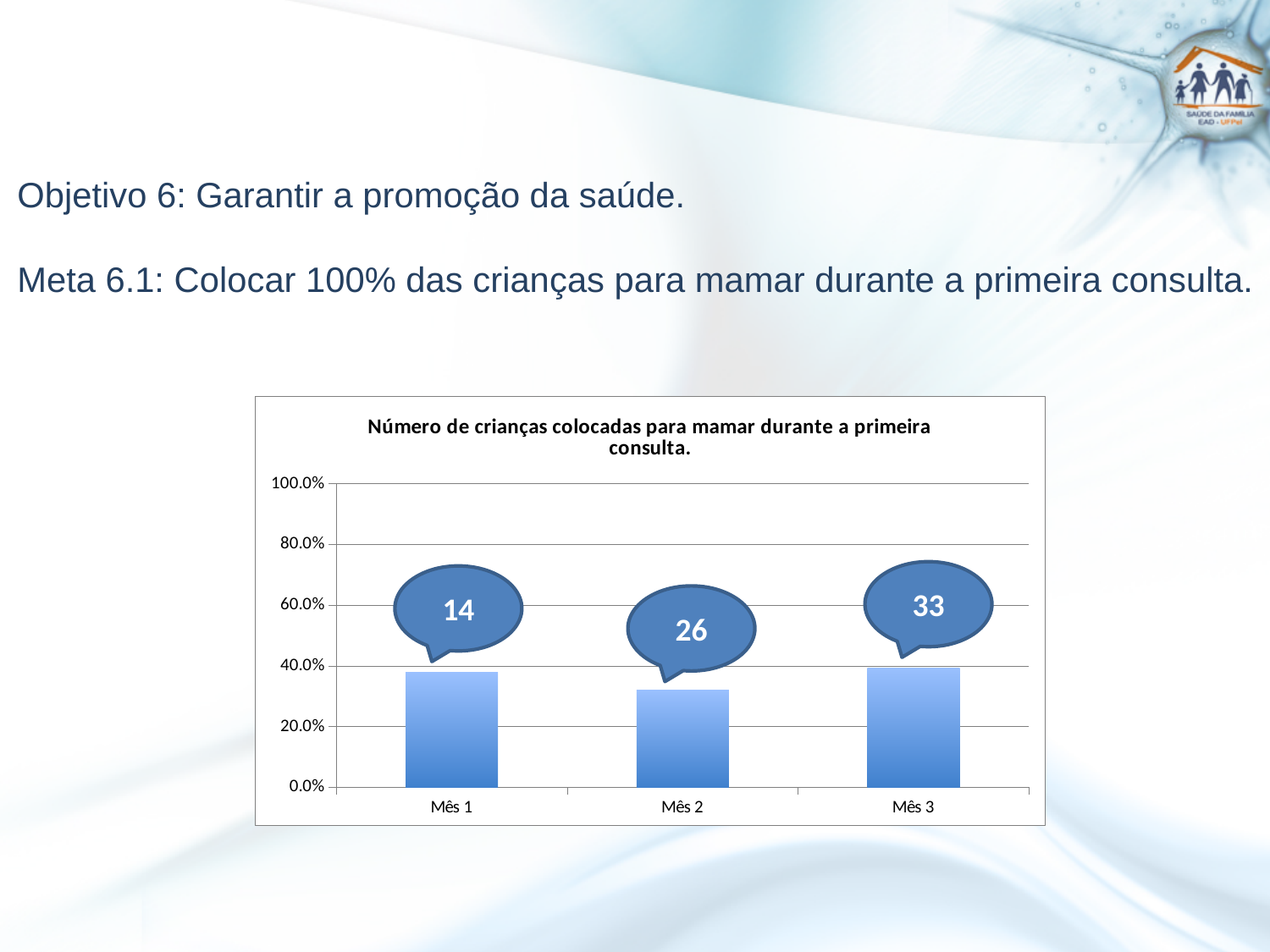
Which month has the lowest bar in the chart? Mês 2 Is the value for Mês 2 greater or less than 20.0%? greater Is the value for Mês 2 greater or less than 40.0%? less Is the value for Mês 1 greater or less than 40.0%? less What is the title of the chart? Número de crianças colocadas para mamar durante a primeira consulta. How many categories (months) are shown on the x axis of the chart? 3 What number is written in the callout above the Mês 2 bar? 26 What kind of chart is shown on the slide? bar chart Which bar is taller, Mês 1 or Mês 2? Mês 1 Which bar is taller, Mês 2 or Mês 3? Mês 3